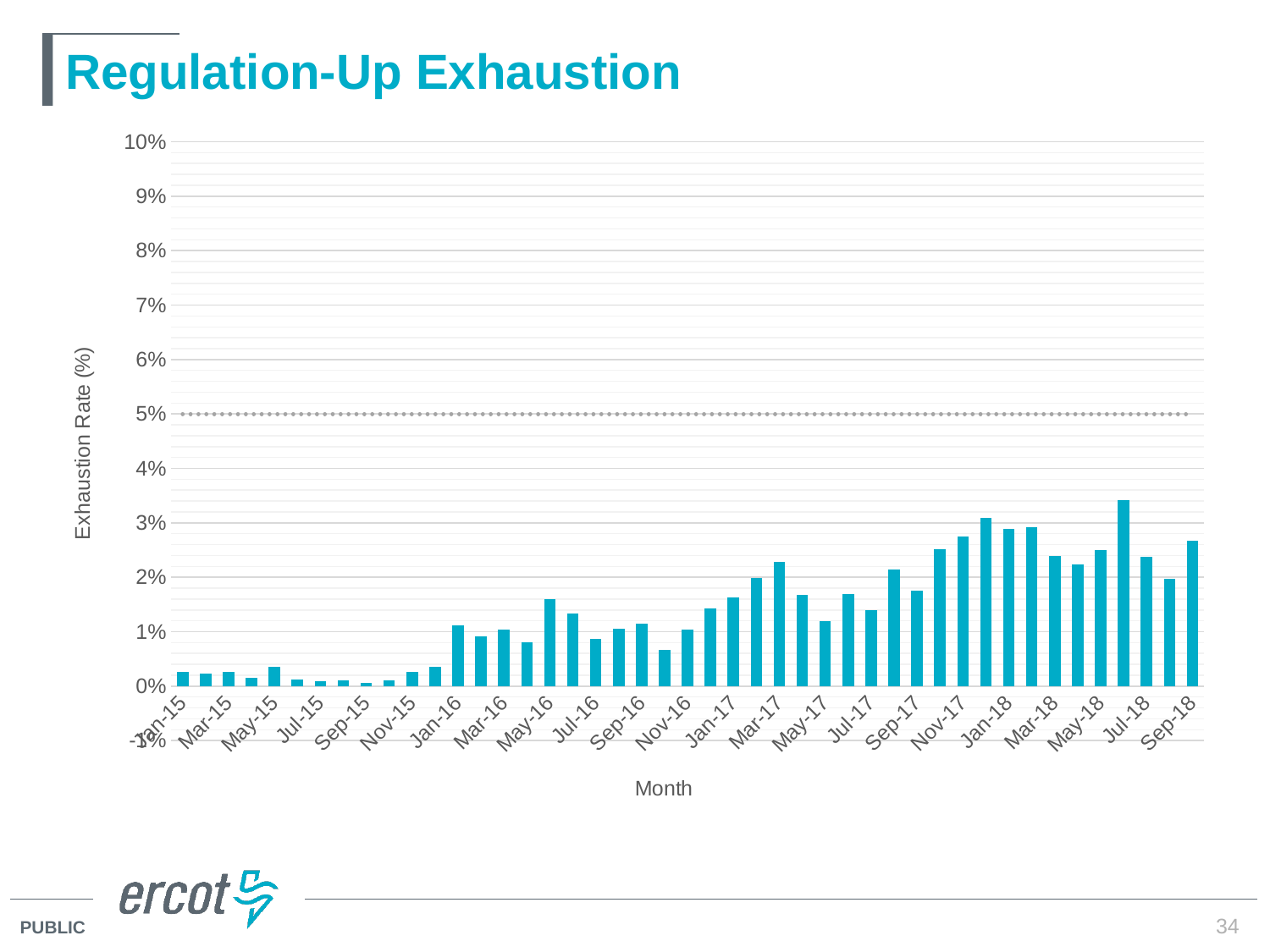
What is the title of the y axis? Exhaustion Rate (%) Is the value for Jan-15 greater or less than 1%? less Is the value for Nov-17 greater or less than 3%? less Is the value for Jul-18 greater or less than 3%? less Which month has the highest exhaustion rate? Jun-18 Do the exhaustion rates generally rise or fall from Jan-15 to Sep-18? rise Which is larger, the value for Sep-18 or the value for Sep-15? Sep-18 At what level is the dotted horizontal reference line drawn? 5% What kind of chart is shown on the slide? bar chart Which is larger, the value for Mar-17 or the value for Mar-16? Mar-17